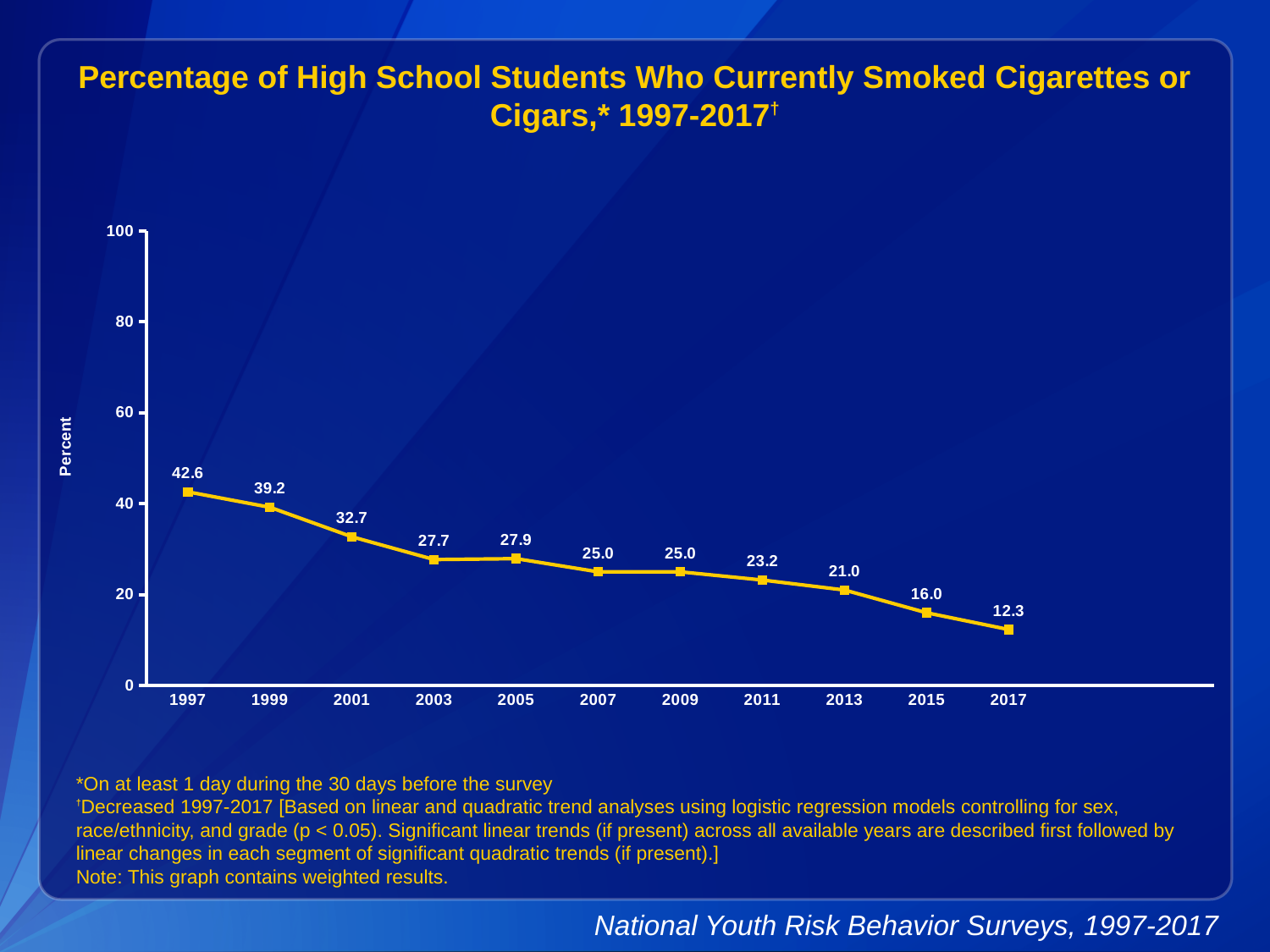
What kind of chart is shown on the slide? Line chart What is the difference between the values for 1997 and 2017? 30.3 What percentage of high school students currently smoked cigarettes or cigars in 1997? 42.6 What is the label on the y axis? Percent What is the difference between the values for 2013 and 2015? 5.0 What is the value plotted for 2017? 12.3 Which year has the lowest value on the chart? 2017 What is the value plotted for 2005? 27.9 How many years are plotted on the x axis? 11 Do the values generally rise or fall from 1997 to 2017? Fall Which year has a larger value, 2001 or 2011? 2001 Which year has the highest value on the chart? 1997